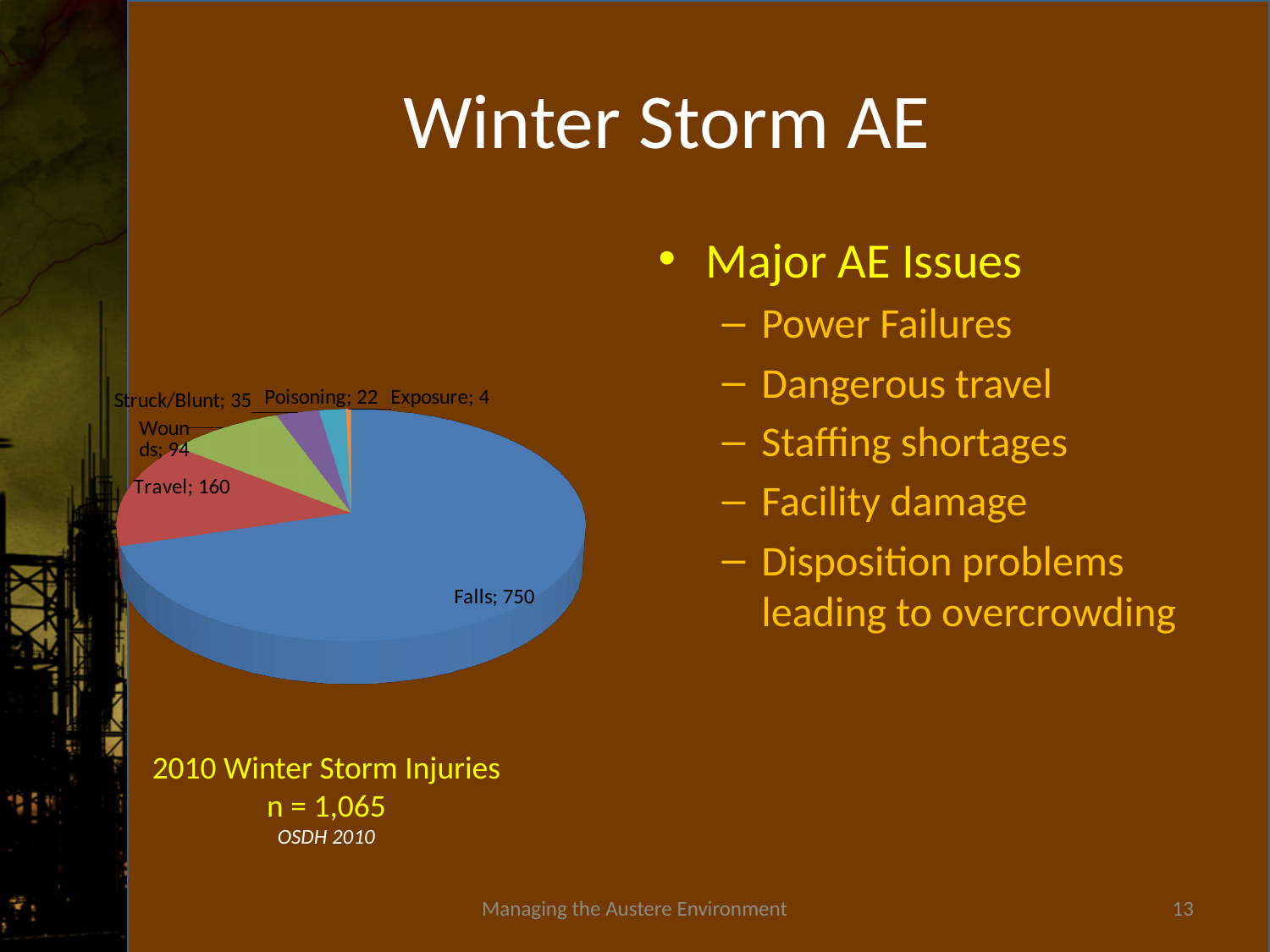
What is the difference between the Struck/Blunt and Poisoning values in the pie chart? 13 What is the value for Travel in the pie chart? 160 What is the value for Wounds in the pie chart? 94 What is the value for Poisoning in the pie chart? 22 What is the difference between the Falls and Travel values in the pie chart? 590 Which injury category has the smallest slice in the pie chart? Exposure Which injury category has the largest slice in the pie chart? Falls What type of chart is shown on the slide? pie chart What is the total number of injuries (n) stated below the pie chart? 1,065 Which is larger in the pie chart, Wounds or Struck/Blunt? Wounds How many injury categories are shown in the pie chart? 6 How many injuries from Falls are shown in the pie chart? 750